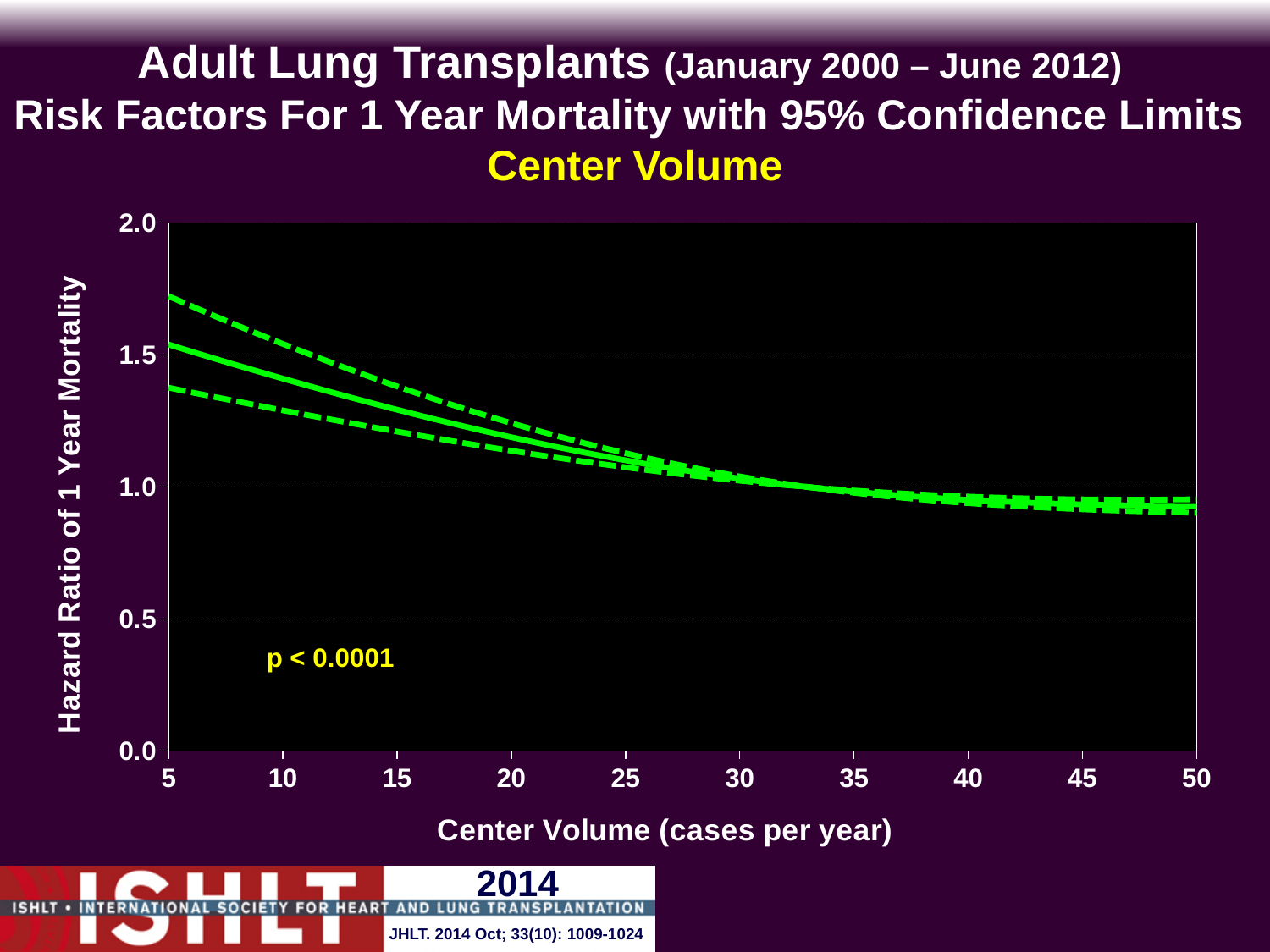
Does the hazard ratio of 1 year mortality rise or fall as center volume increases from 5 to 50 cases per year? Fall Is the hazard ratio on the solid line at a center volume of 20 cases per year greater or less than 1.0? greater Is the hazard ratio on the solid line at a center volume of 10 cases per year greater or less than 1.5? less What kind of chart is shown on the slide? Line chart What p-value is printed on the chart? p < 0.0001 Is the lower dashed confidence limit at a center volume of 5 cases per year greater or less than 1.5? less How many tick labels are shown on the x axis of the chart? 10 What is the label of the x axis of the chart? Center Volume (cases per year)